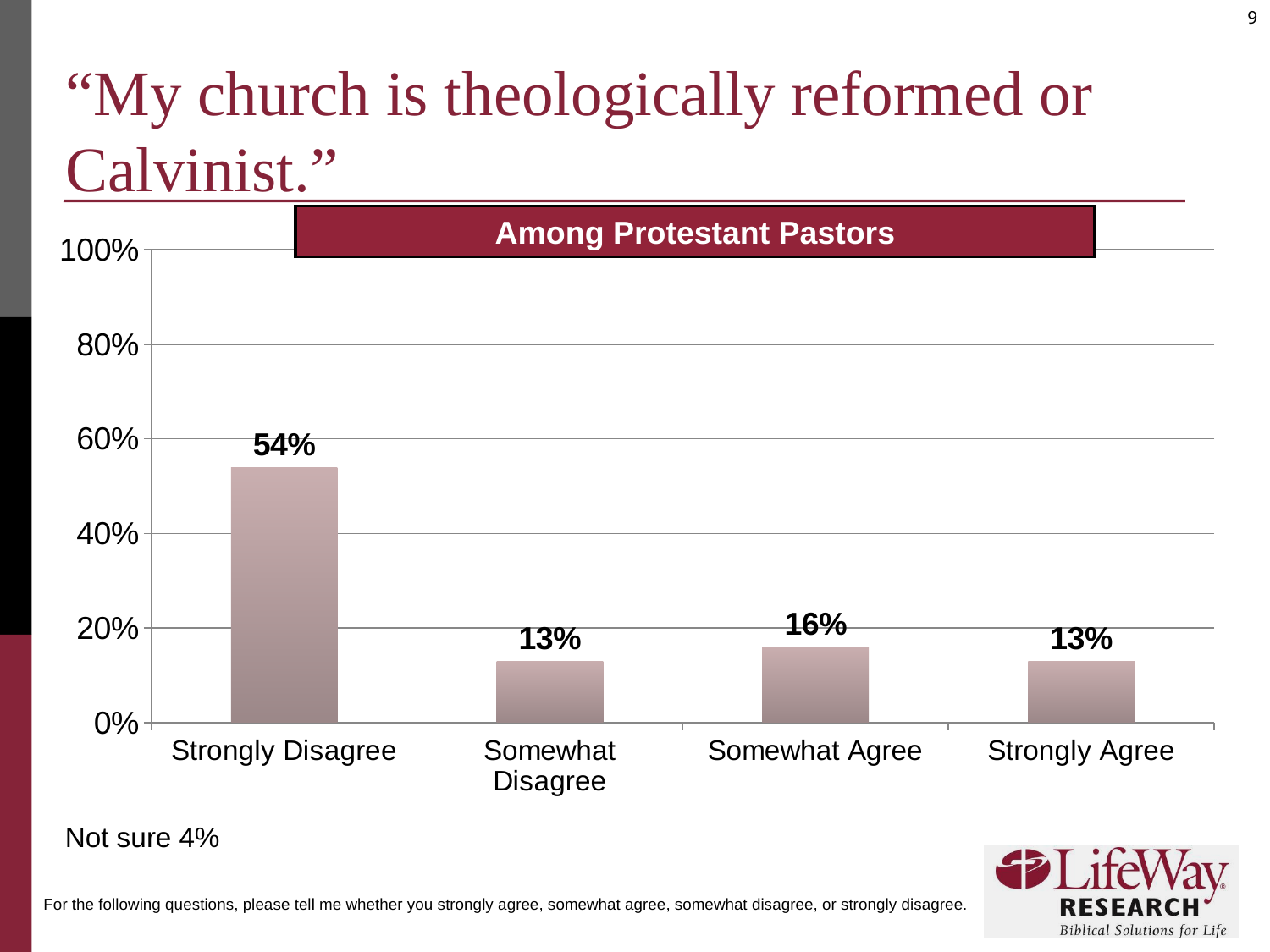
What kind of chart is shown on the slide? Bar chart What group does the chart's header say the results are among? Protestant Pastors Which response category has the highest value? Strongly Disagree Which is larger, the value for Somewhat Agree or the value for Somewhat Disagree? Somewhat Agree What is the value for Somewhat Agree? 16% What percentage of pastors answered Not sure, as noted below the chart? 4% What is the difference between the Strongly Disagree and Somewhat Agree values? 38 percentage points What is the difference between the Somewhat Agree and Strongly Agree values? 3 percentage points How many response categories are shown on the x axis? 4 Is the value for Strongly Disagree greater or less than 40%? greater What percentage of Protestant pastors strongly disagree that their church is theologically reformed or Calvinist? 54% What is the value for Strongly Agree? 13%